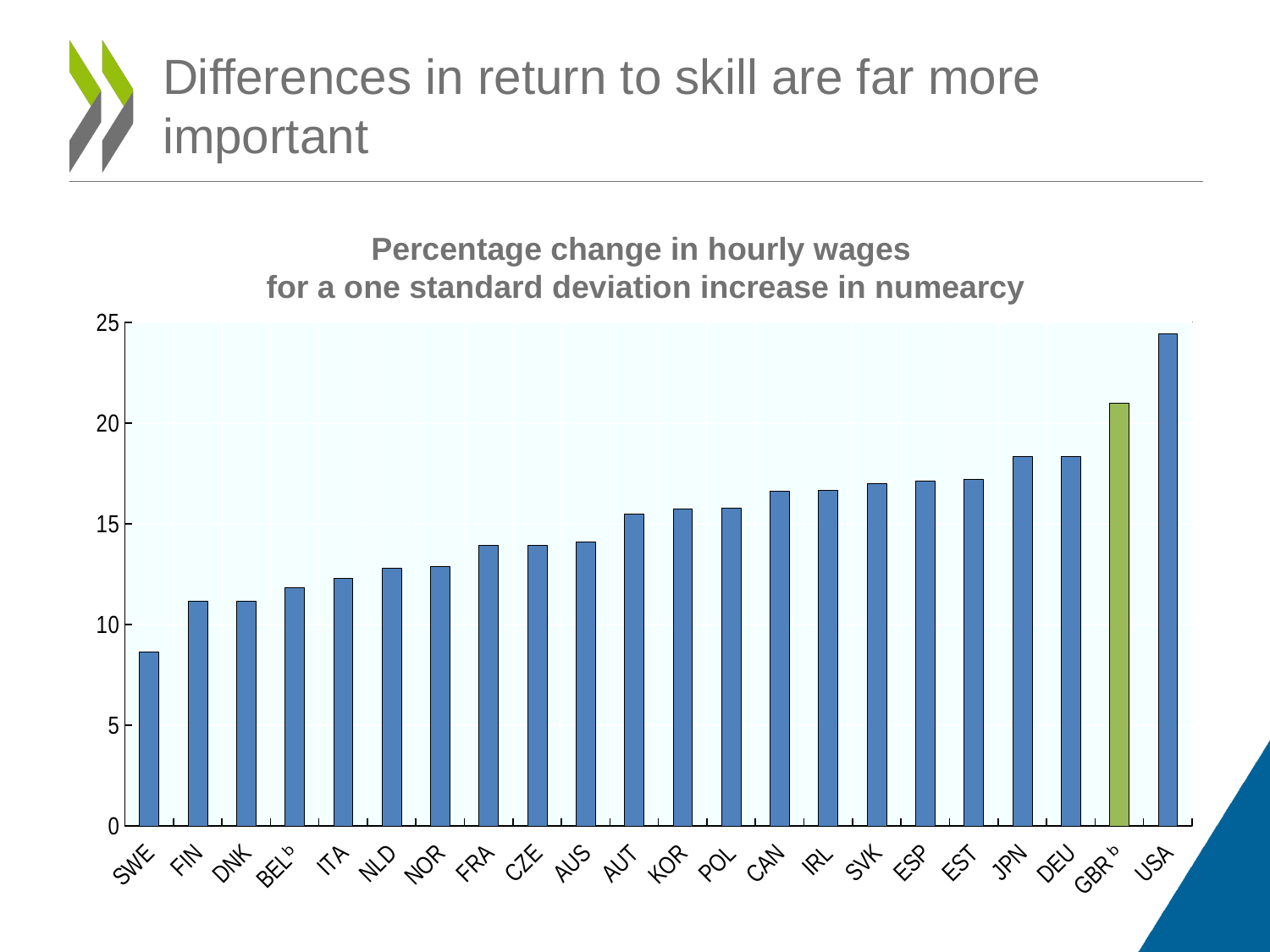
Which country has the lowest percentage change in hourly wages? SWE Which country's bar is shown in a different colour (green) from the others? GBR What kind of chart is shown on the slide? bar chart Is the value for USA greater or less than 20? greater Is the value for SWE greater or less than 10? less Do the values generally rise or fall from left to right along the x axis? rise Is the value for GBR greater or less than 20? greater Which country has the highest percentage change in hourly wages? USA How many countries are shown on the x axis? 22 Which is larger, the value for USA or the value for GBR? USA